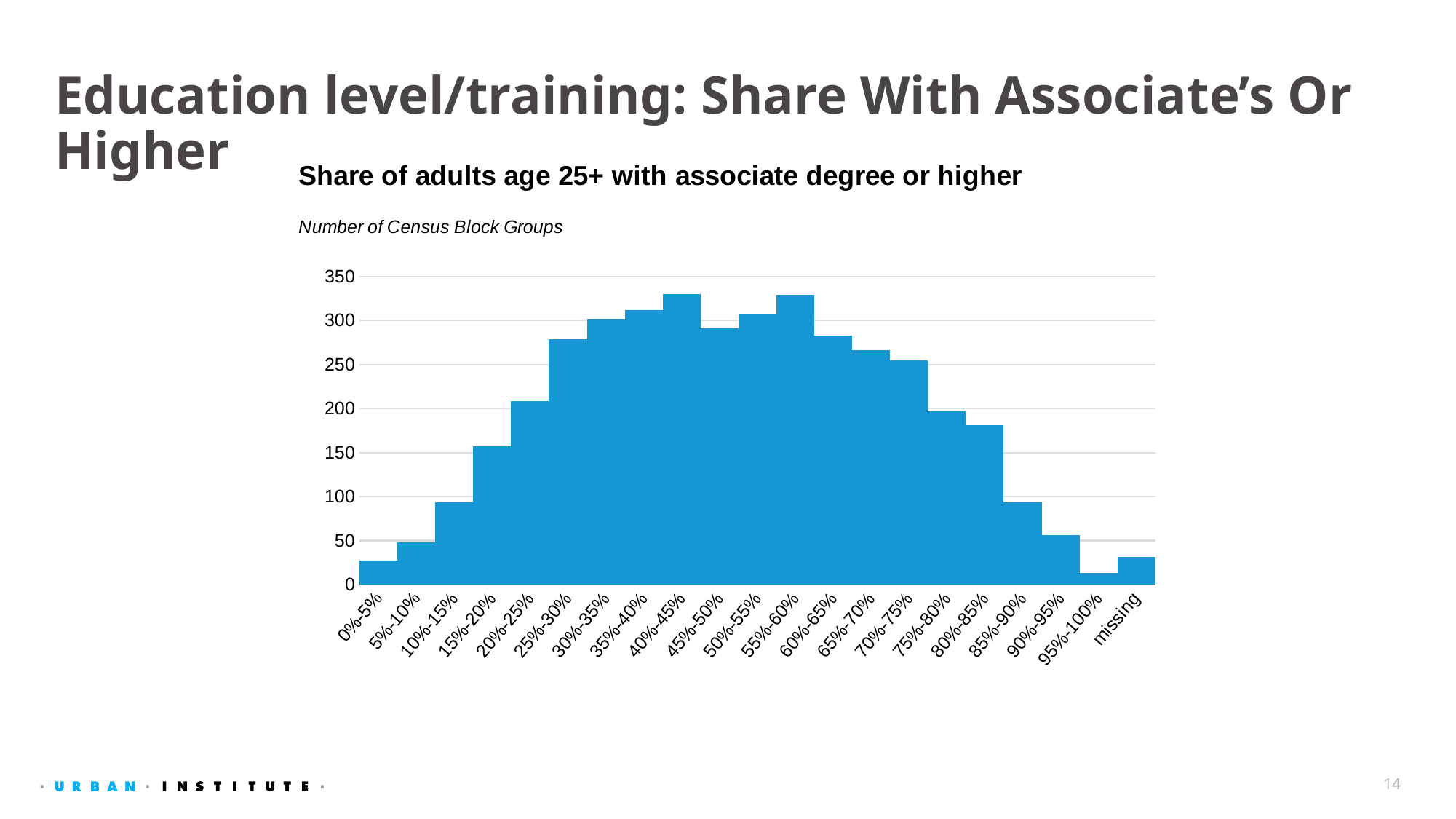
Which has more census block groups, 20%-25% or 70%-75%? 70%-75% How many categories are shown on the x axis of the chart? 21 Is the value for 0%-5% greater or less than 50? less What kind of chart is shown on the slide? bar chart Which has more census block groups, 10%-15% or 90%-95%? 10%-15% Do the values rise or fall along the x axis from 0%-5% to 40%-45%? rise What is the title of the chart? Share of adults age 25+ with associate degree or higher Is the value for 40%-45% greater or less than 300? greater Is the value for 15%-20% greater or less than 150? greater Which category has the lowest number of census block groups? 95%-100%